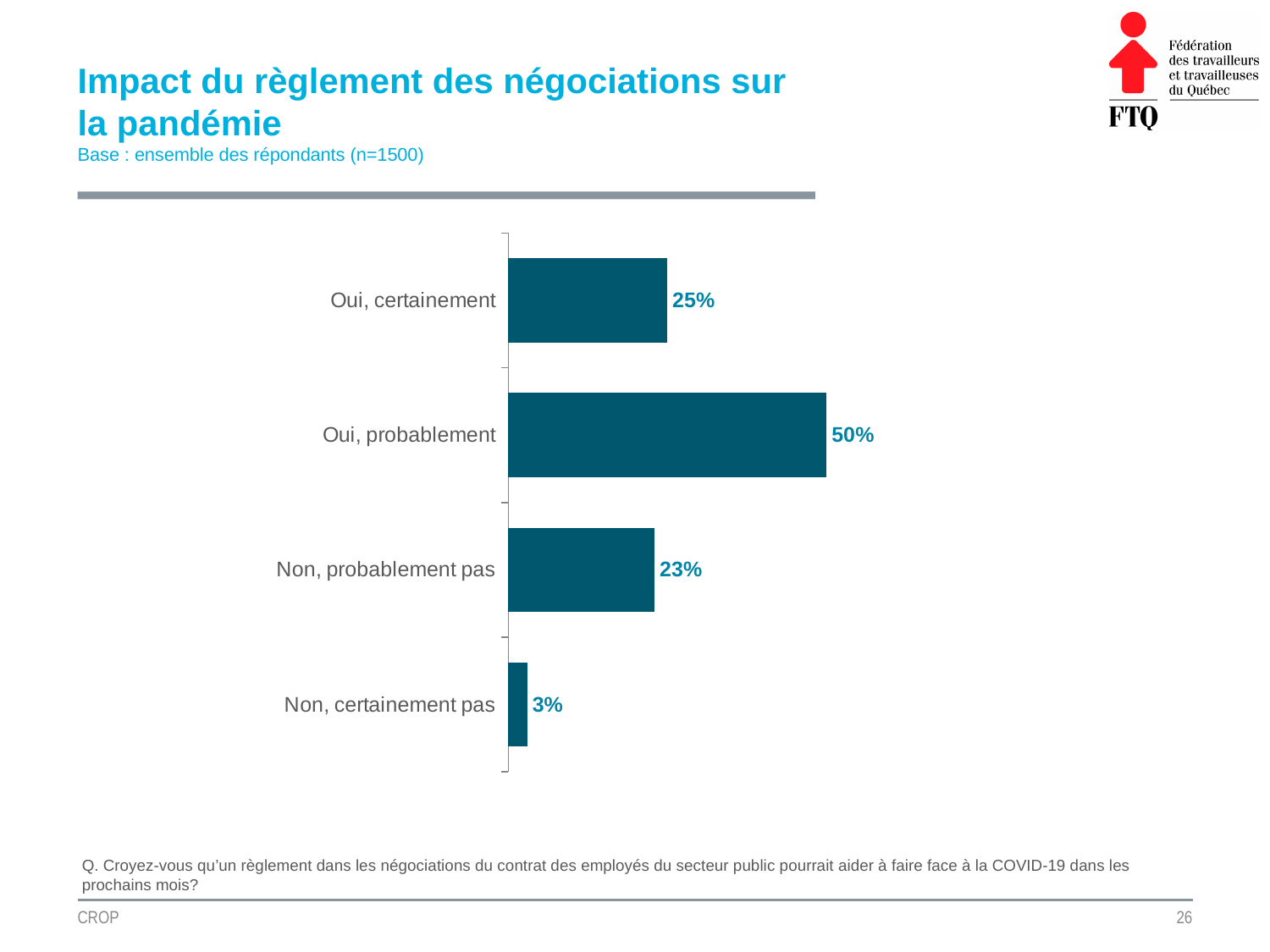
Which category has the lowest value? Non, certainement pas Which category has the highest value? Oui, probablement What is the difference between the values for "Non, probablement pas" and "Non, certainement pas"? 20% What is the title of the slide containing the chart? Impact du règlement des négociations sur la pandémie What is the value for "Non, certainement pas"? 3% What kind of chart is shown on the slide? Bar chart What is the value for "Non, probablement pas"? 23% What is the value for "Oui, probablement"? 50% How many categories are shown in the chart? 4 What is the value for "Oui, certainement"? 25% Which is larger, the value for "Oui, certainement" or the value for "Non, probablement pas"? Oui, certainement What is the difference between the values for "Oui, probablement" and "Oui, certainement"? 25%